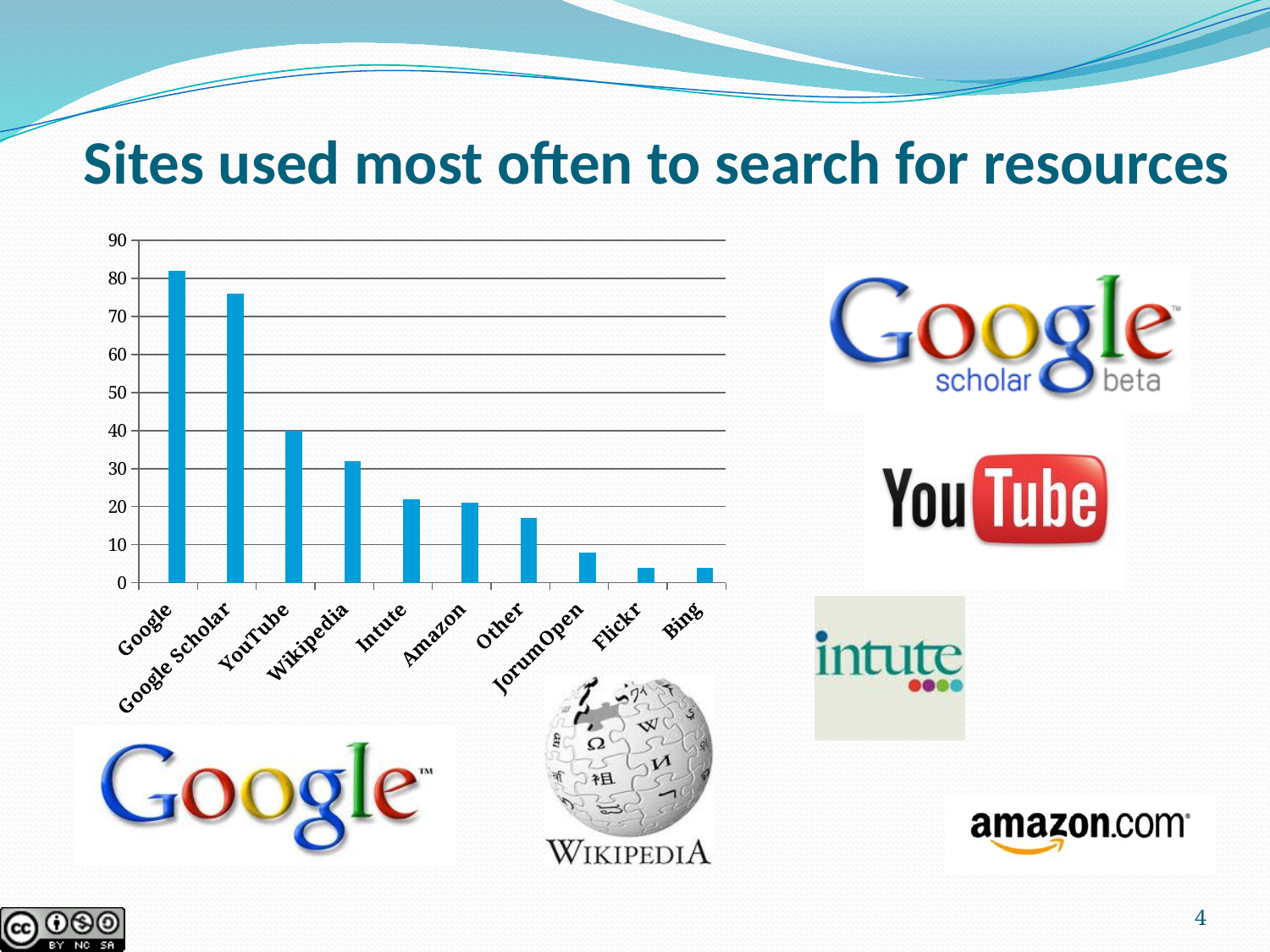
Which has a larger value, Wikipedia or Intute? Wikipedia Which site has the highest value in the chart? Google Which has a larger value, Google or YouTube? Google Do the values generally rise or fall moving from left to right along the x axis? fall Is the value for Google Scholar greater or less than 70? greater Is the value for Google greater or less than 80? greater Is the value for JorumOpen greater or less than 10? less What kind of chart is shown on the slide? bar chart What is the title of the chart? Sites used most often to search for resources How many sites (categories) are shown on the x axis of the chart? 10